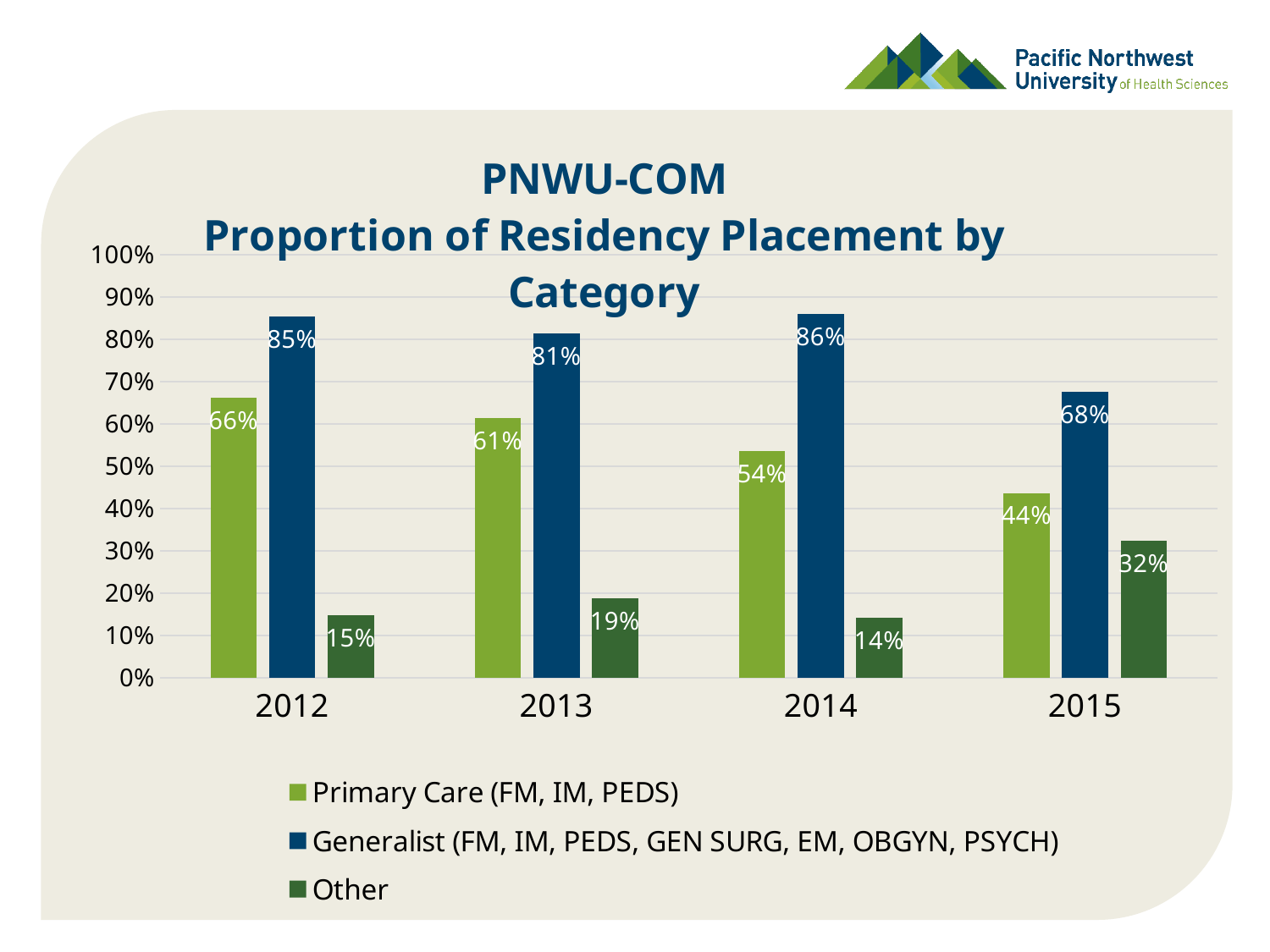
In which year is the Other value lowest? 2014 What is the Generalist value for 2014? 86% Which is larger: the Primary Care value for 2013 or the Primary Care value for 2014? 2013 What is the Primary Care (FM, IM, PEDS) value for 2015? 44% What is the Primary Care (FM, IM, PEDS) value for 2012? 66% Does the Primary Care (FM, IM, PEDS) value rise or fall from 2012 to 2015? fall What is the Other value for 2015? 32% What is the difference between the Generalist values for 2012 and 2015? 17% In which year is the Generalist value highest? 2014 How many series does the legend list? 3 Is the Other value for 2013 greater or less than 10%? greater How many years are shown on the x axis? 4